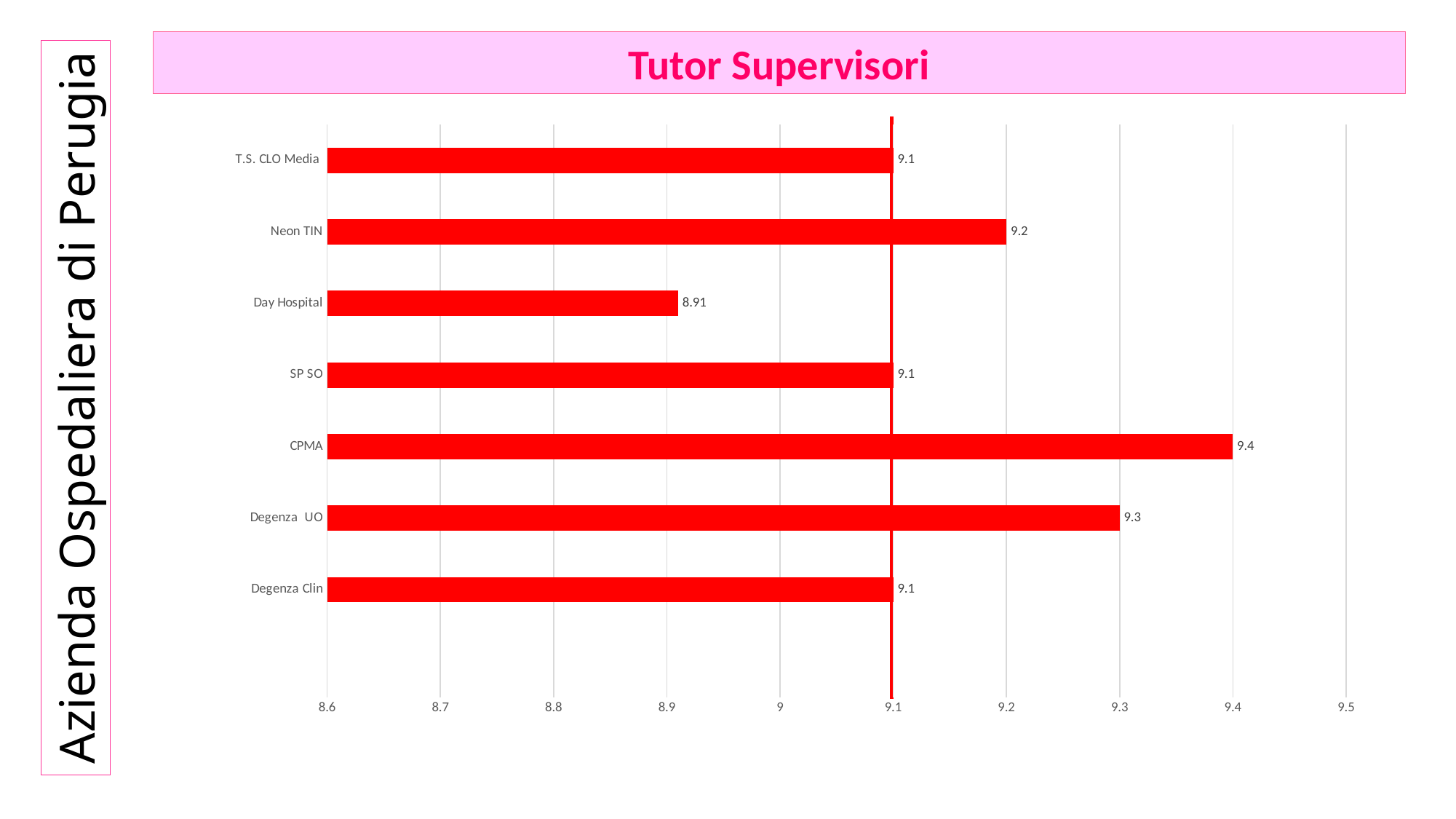
Which category has the lowest value? Day Hospital How many categories are shown on the chart? 7 What is the value for Neon TIN? 9.2 What is the value for Day Hospital? 8.91 Which is larger, the value for Neon TIN or the value for Degenza UO? Degenza UO Is the value for Day Hospital greater or less than 9? less What is the difference between the values for CPMA and Day Hospital? 0.49 What is the value for CPMA? 9.4 Which category has the highest value? CPMA What kind of chart is shown on the slide? bar chart What is the title of the chart? Tutor Supervisori What is the value for Degenza UO? 9.3